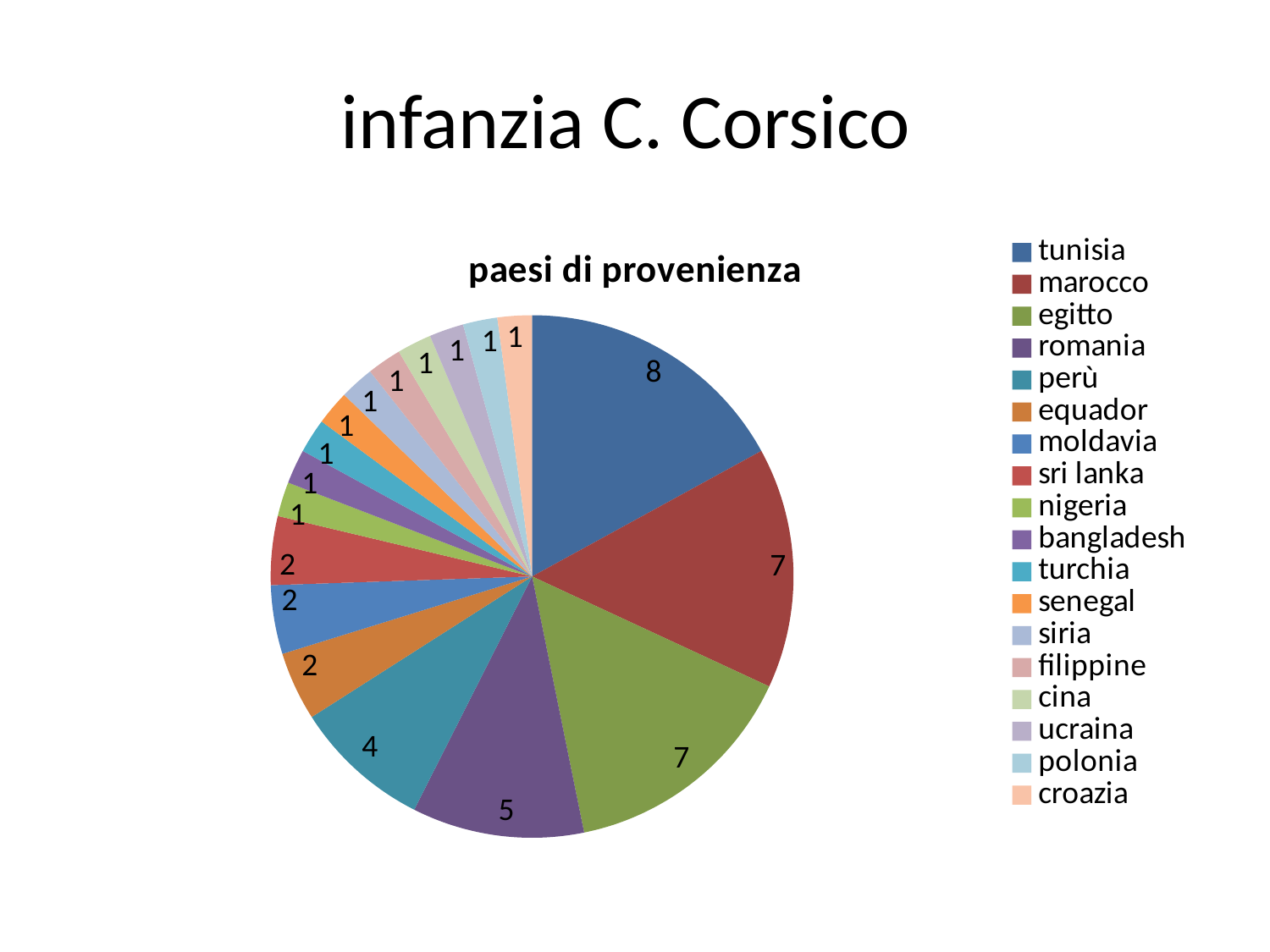
How many countries are listed in the legend? 18 What type of chart is shown on the slide? pie chart Which is larger, the value for perù or the value for moldavia? perù What is the title of the chart? paesi di provenienza Which country has the largest slice? tunisia What is the value for marocco? 7 What is the value for romania? 5 What is the difference between the values for tunisia and romania? 3 What is the value for tunisia? 8 What is the value for perù? 4 What is the difference between the values for egitto and perù? 3 What is the value for equador? 2